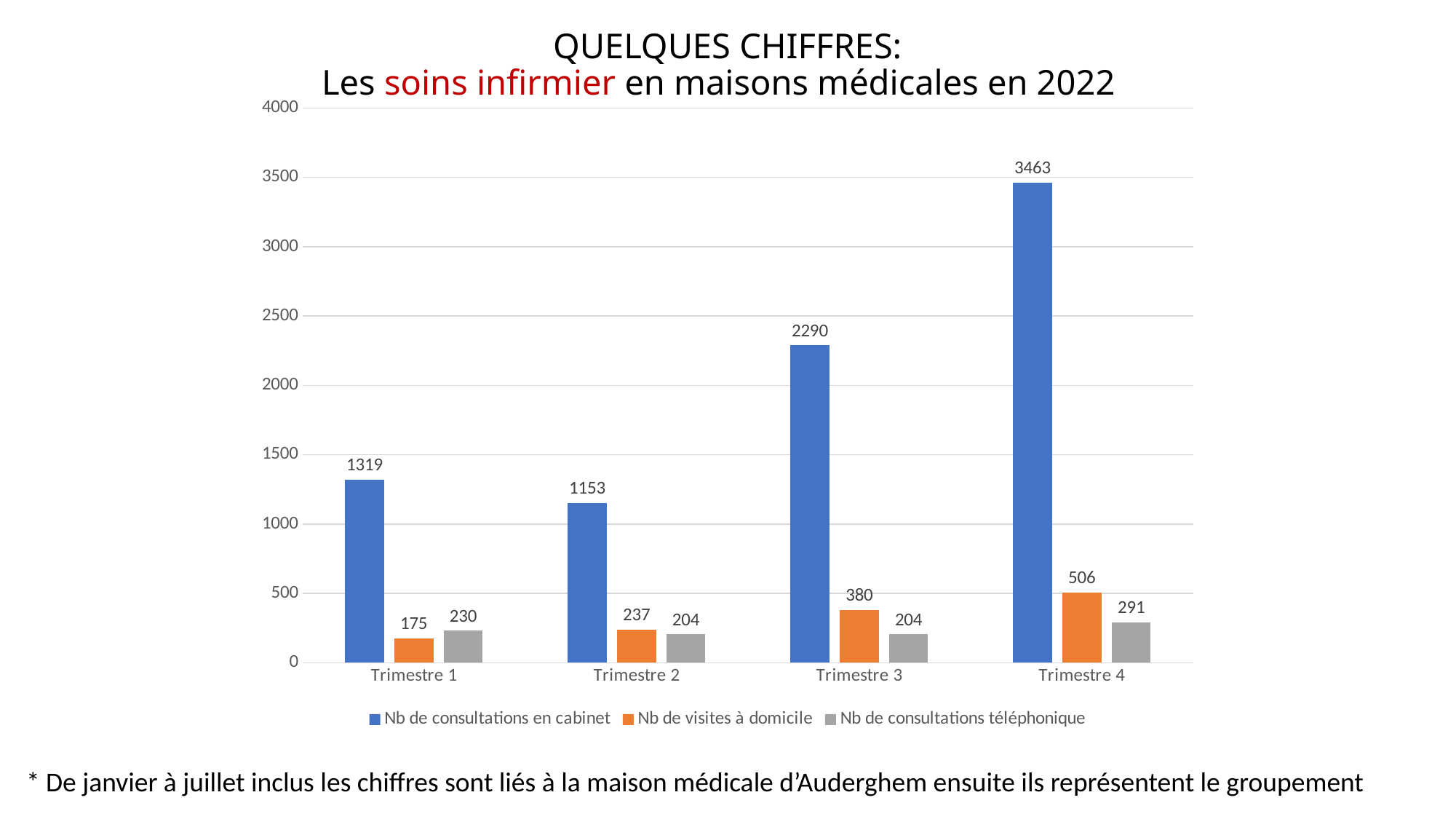
Which trimestre has the lowest value for 'Nb de visites à domicile'? Trimestre 1 Which trimestre has the highest value for 'Nb de consultations en cabinet'? Trimestre 4 What is the difference between 'Nb de consultations en cabinet' in Trimestre 4 and Trimestre 3? 1173 What kind of chart is shown on the slide? bar chart How many series does the legend list? 3 Is the value of 'Nb de consultations en cabinet' for Trimestre 3 greater or less than 2000? greater What is the value of 'Nb de visites à domicile' for Trimestre 2? 237 What is the value of 'Nb de consultations téléphonique' for Trimestre 1? 230 Which is larger in Trimestre 1: 'Nb de visites à domicile' or 'Nb de consultations téléphonique'? Nb de consultations téléphonique What is the value of 'Nb de consultations en cabinet' for Trimestre 4? 3463 Which colour represents 'Nb de visites à domicile' in the chart? orange How many trimestres are shown on the x axis? 4